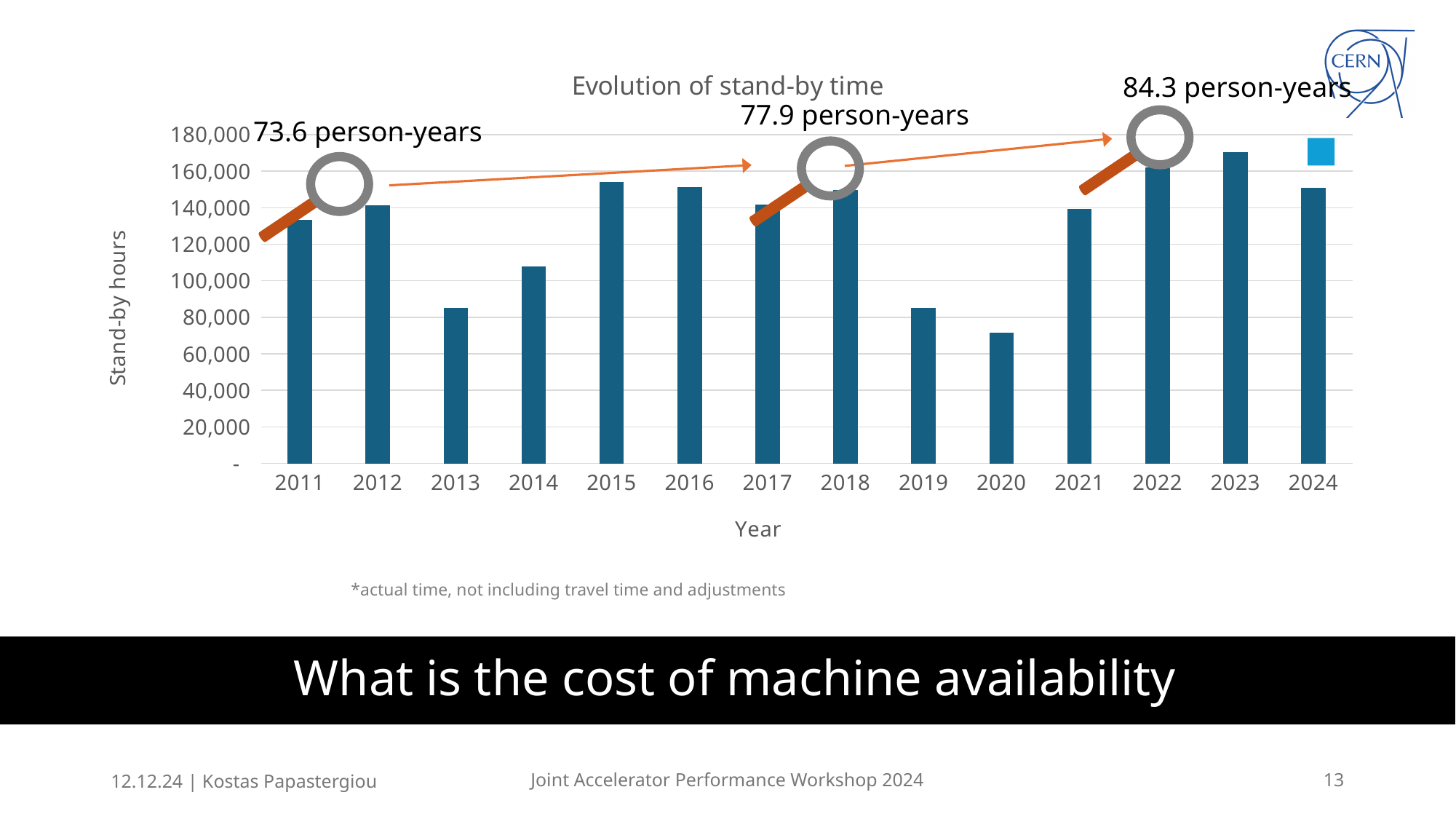
Is the value for 2014 greater or less than 100,000? greater Which year has more stand-by hours, 2014 or 2015? 2015 Which year has the lowest stand-by hours? 2020 How many years are shown on the x axis of the chart? 14 Do the stand-by hours rise or fall from 2020 to 2023? rise What kind of chart is shown on the slide? bar chart Is the value for 2020 greater or less than 80,000? less What is the title of the chart? Evolution of stand-by time Which year has the highest stand-by hours? 2023 Is the value for 2023 greater or less than 160,000? greater What is the label of the vertical axis of the chart? Stand-by hours Which year has more stand-by hours, 2021 or 2022? 2022